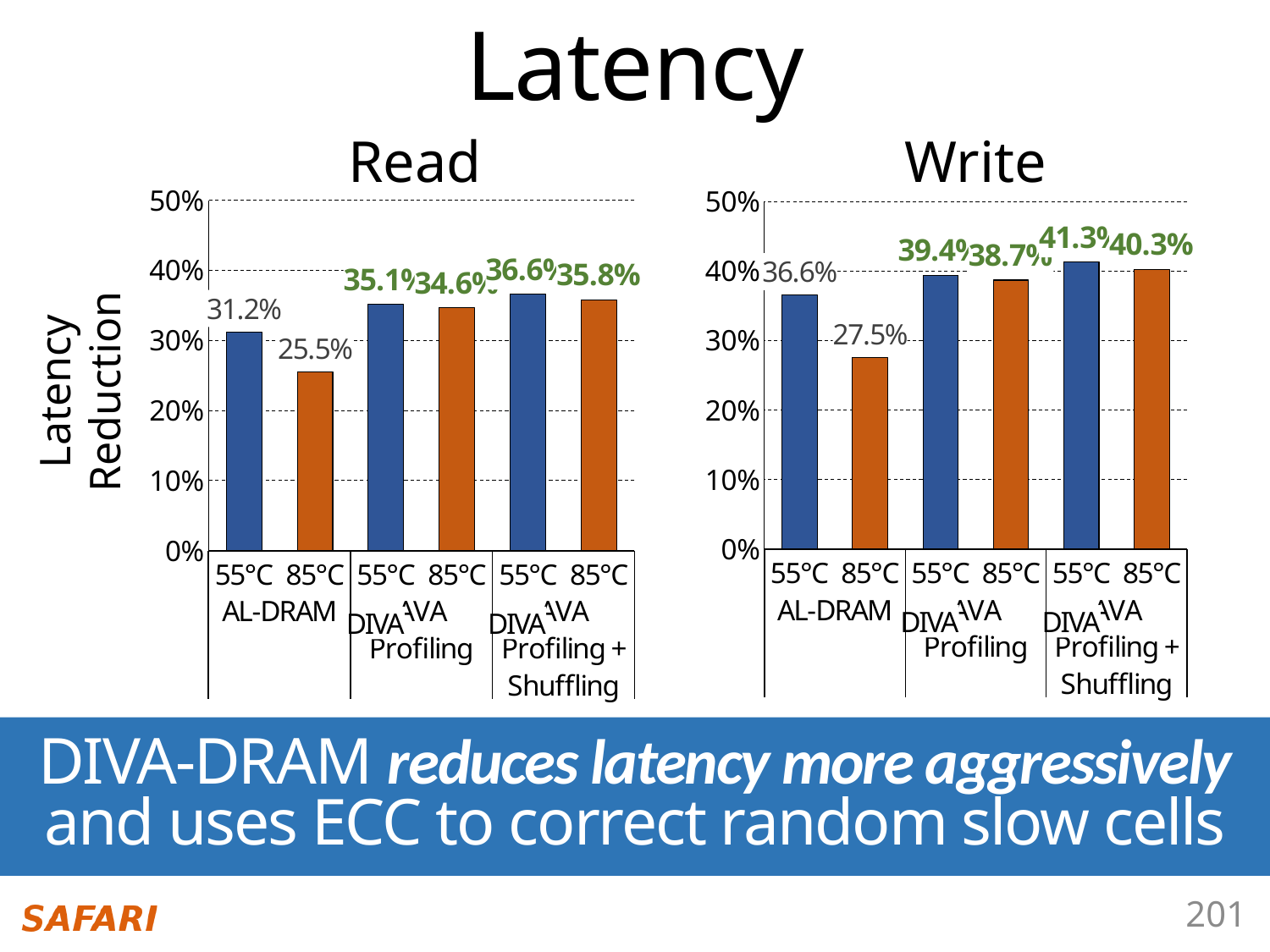
In the Write chart, is the latency reduction for DIVA Profiling at 55°C greater or less than 30%? greater In the Write chart, which bar has the lowest latency reduction? AL-DRAM at 85°C In the Write chart, what is the latency reduction for DIVA Profiling + Shuffling at 55°C? 41.3% In the Read chart, which is larger: the latency reduction for AL-DRAM at 85°C or for DIVA Profiling at 85°C? DIVA Profiling at 85°C In the Write chart, what is the latency reduction for AL-DRAM at 85°C? 27.5% In the Read chart, which bar has the highest latency reduction? DIVA Profiling + Shuffling at 55°C In the Read chart, what is the difference between the AL-DRAM latency reduction at 55°C and at 85°C? 5.7% In the Write chart, what is the difference between the AL-DRAM latency reduction at 55°C and at 85°C? 9.1% In the Read chart, what is the latency reduction for AL-DRAM at 85°C? 25.5% In the Read chart, what is the latency reduction for AL-DRAM at 55°C? 31.2% How many bars are plotted in the Write chart? 6 What type of chart is the Read chart? Bar chart